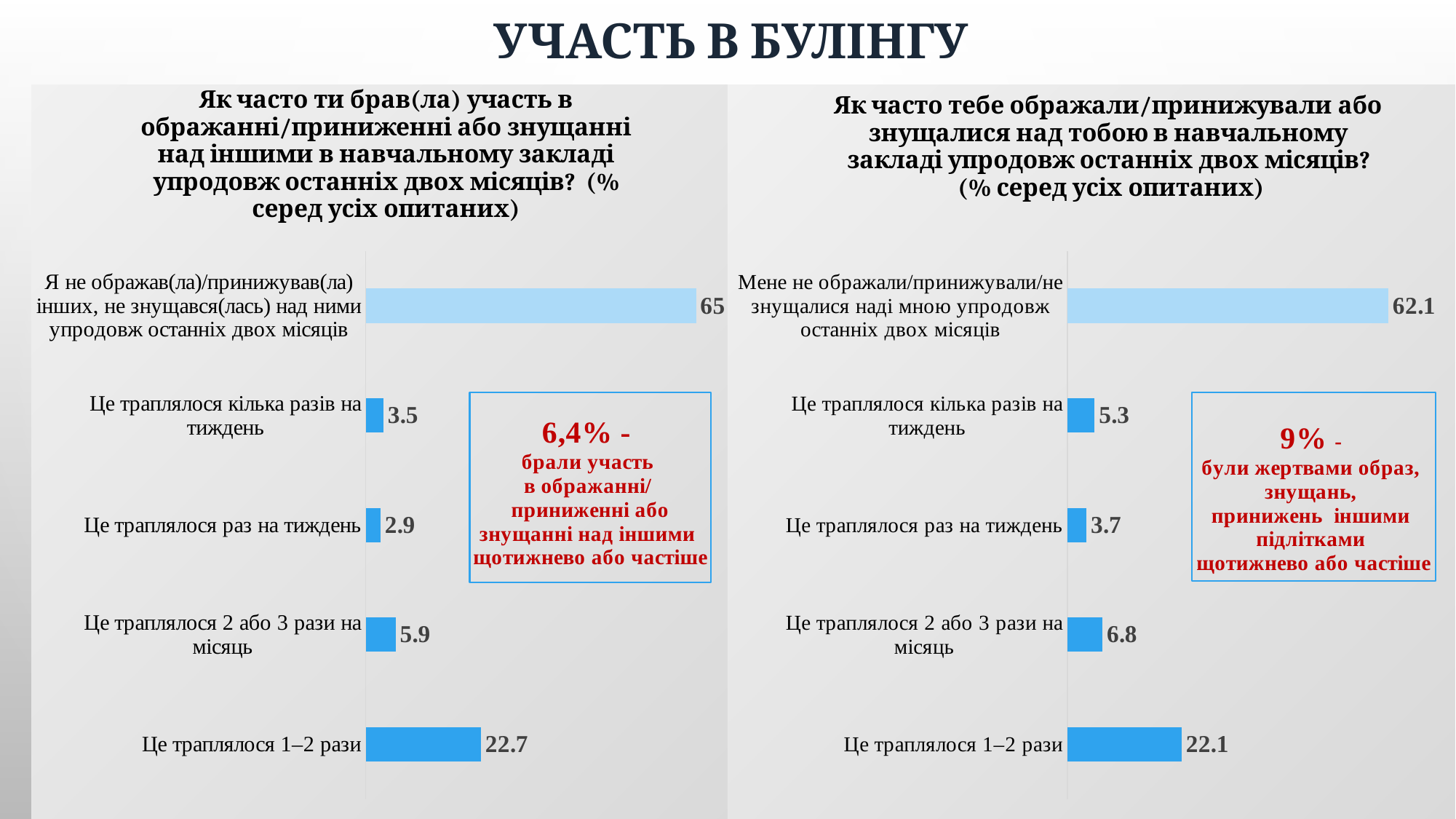
In the left chart, which category has the lowest value? Це траплялося раз на тиждень In the right chart, what is the difference between the values for "Це траплялося 1–2 рази" and "Це траплялося 2 або 3 рази на місяць"? 15.3 In the left chart, what is the value for "Це траплялося раз на тиждень"? 2.9 In the right chart, which category has the highest value? Мене не ображали/принижували/не знущалися наді мною упродовж останніх двох місяців What type of chart is the right chart? Bar chart Which is larger: the value for "Це траплялося 2 або 3 рази на місяць" in the left chart or in the right chart? Right chart (6.8) In the right chart, what is the value for "Це траплялося кілька разів на тиждень"? 5.3 In the left chart, what is the value for "Це траплялося 1–2 рази"? 22.7 What percentage is highlighted in the red text box on the right chart? 9% In the left chart, what is the difference between the values for "Це траплялося 2 або 3 рази на місяць" and "Це траплялося кілька разів на тиждень"? 2.4 In the right chart, which category has the lowest value? Це траплялося раз на тиждень How many categories does the left chart show? 5